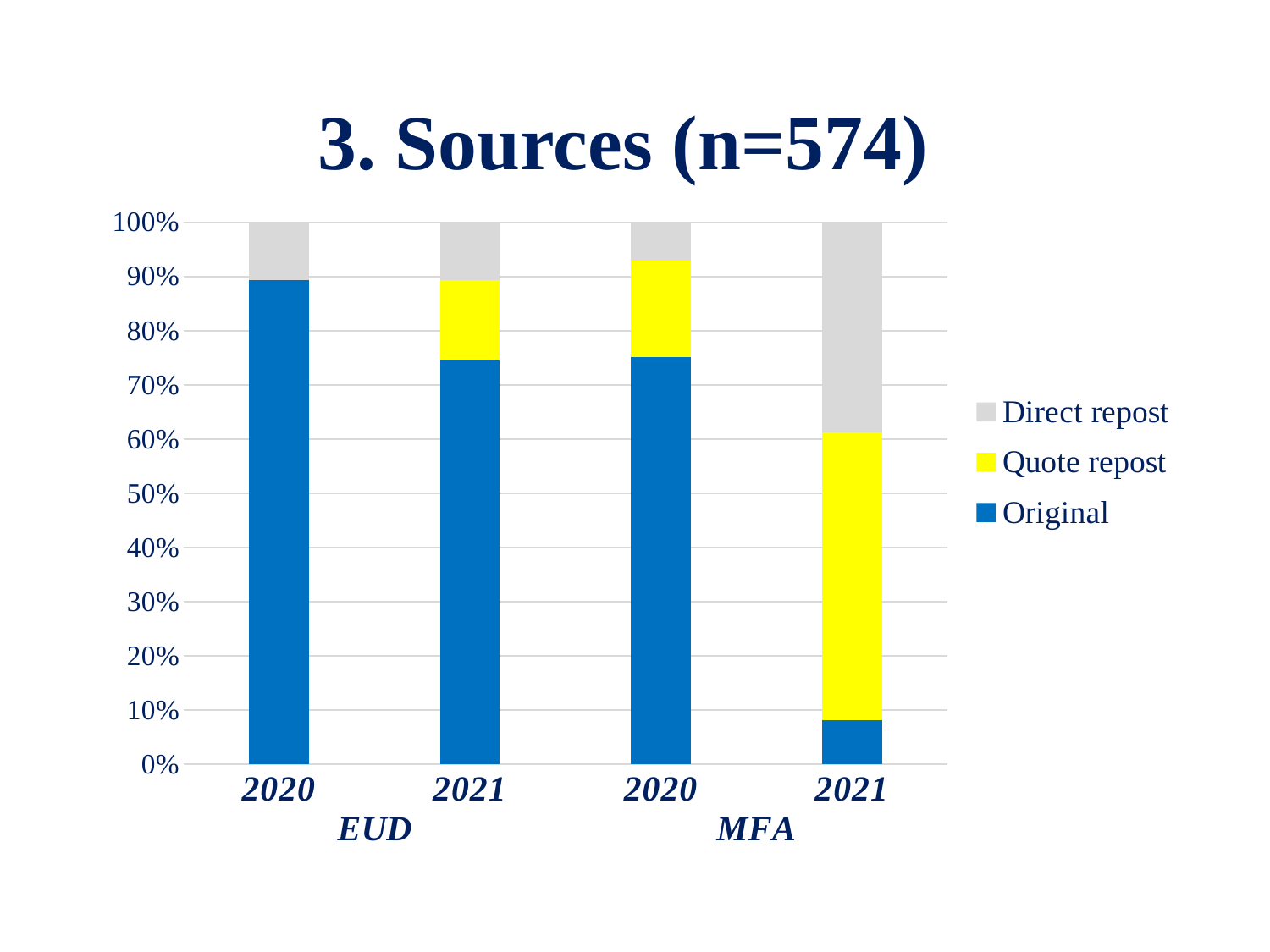
Which has the larger Original share, EUD 2021 or MFA 2021? EUD 2021 Is the Original share for MFA 2021 greater or less than 10%? less Does the Original share for EUD rise or fall from 2020 to 2021? fall Is the Original share for MFA 2020 greater or less than 70%? greater Which bar has the largest Original share? EUD 2020 Is the Original share for EUD 2020 greater or less than 80%? greater What kind of chart is shown on the slide? Stacked bar chart How many series does the legend list? 3 Which bar has the largest Direct repost share? MFA 2021 Which bar has the smallest Original share? MFA 2021 How many bars are plotted in the chart? 4 What is the title of the chart? 3. Sources (n=574)